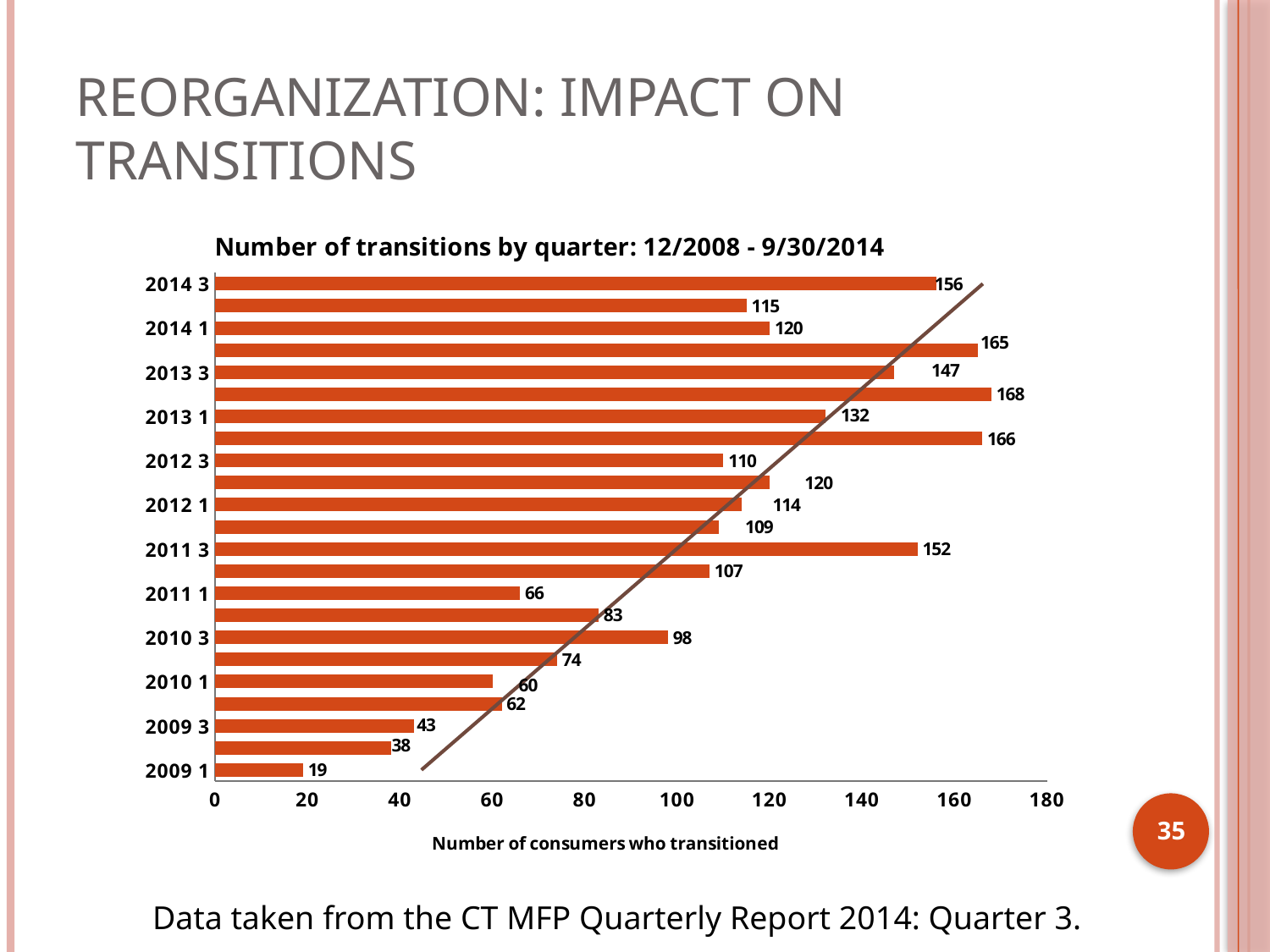
What is the label of the horizontal axis? Number of consumers who transitioned Which has more transitions, 2013 1 or 2012 3? 2013 1 What is the difference in transitions between 2014 3 and 2014 1? 36 What is the highest number of transitions shown on the chart? 168 What is the number of transitions for 2013 3? 147 What kind of chart is shown on the slide? Bar chart What is the number of transitions for 2010 1? 60 How many bars are plotted on the chart? 23 What is the number of transitions for 2014 3? 156 What is the number of transitions for 2011 3? 152 Which quarter has the lowest number of transitions? 2009 1 What is the number of transitions for 2009 1? 19